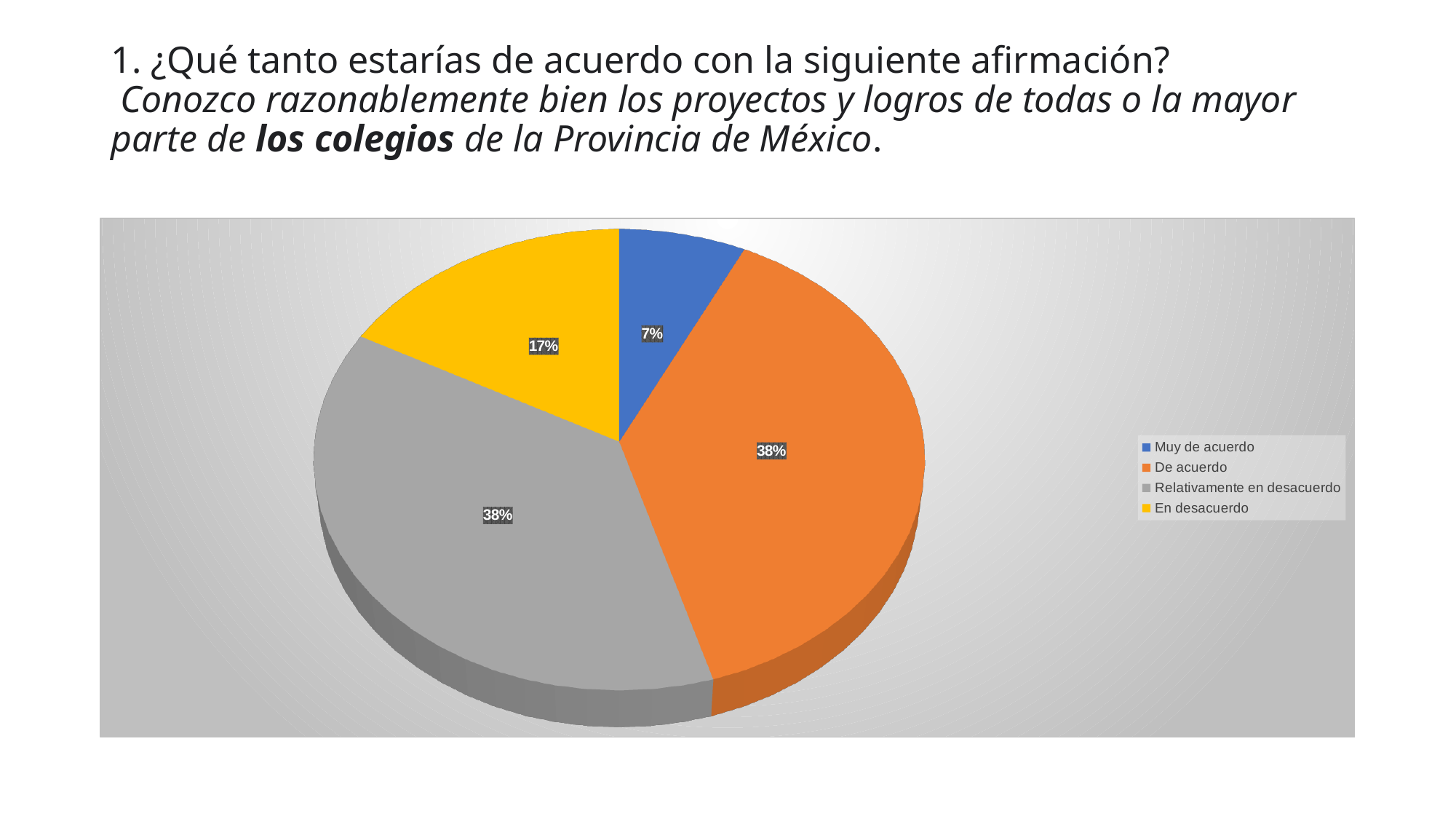
What kind of chart is shown on the slide? Pie chart How many categories does the legend list? 4 What is the difference between the shares for "En desacuerdo" and "Muy de acuerdo"? 10% Which category has the smallest slice of the pie? Muy de acuerdo What share of the pie does "Muy de acuerdo" represent? 7% Which is larger, the share for "En desacuerdo" or the share for "Muy de acuerdo"? En desacuerdo What colour is the slice for "En desacuerdo"? Yellow What is the combined share of "De acuerdo" and "Relativamente en desacuerdo"? 76% What share of the pie does "De acuerdo" represent? 38% What share of the pie does "Relativamente en desacuerdo" represent? 38% What share of the pie does "En desacuerdo" represent? 17% Which category is shown in orange in the legend? De acuerdo